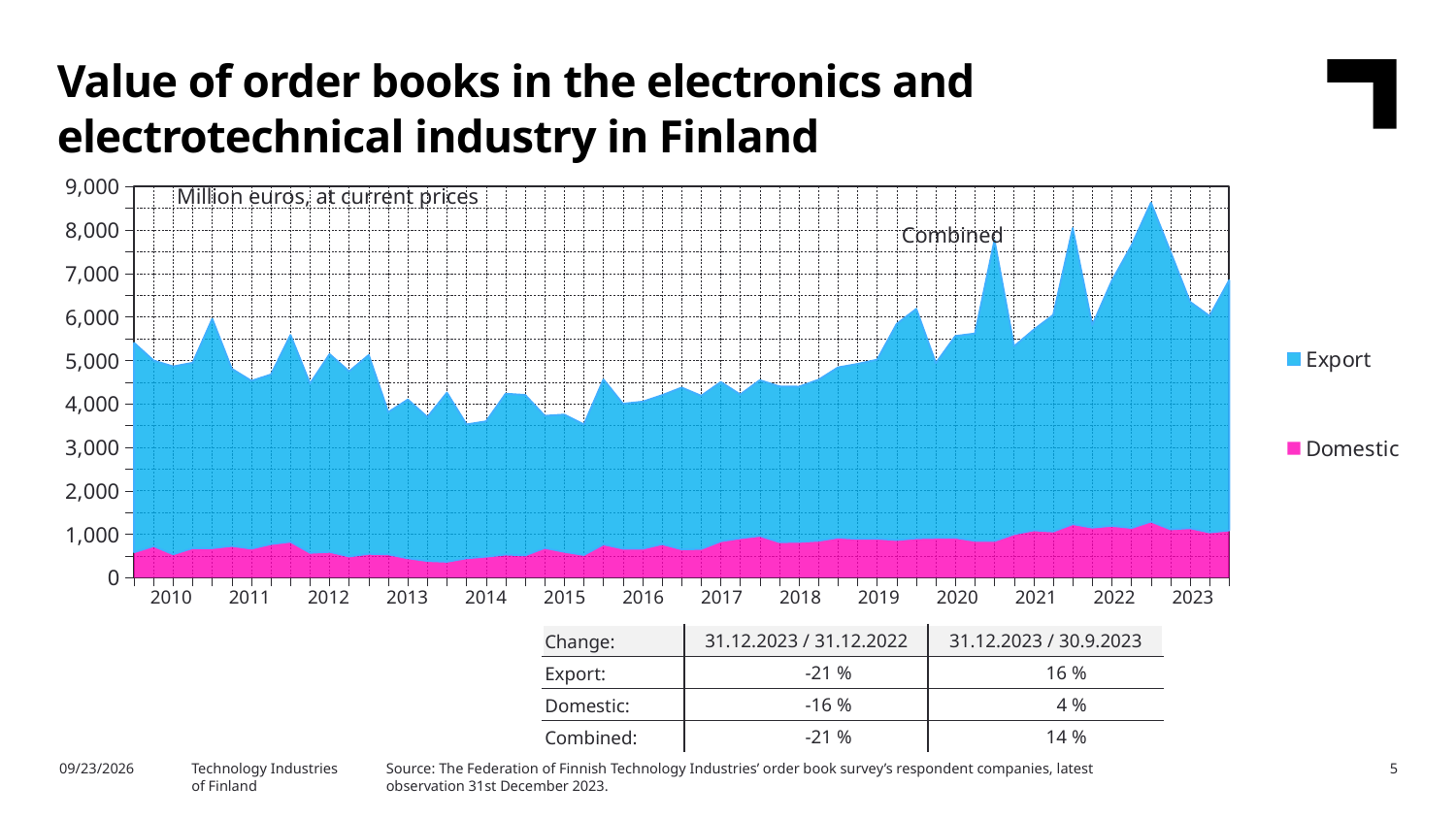
Is the highest combined peak in 2022 greater or less than 8,000? greater Is the lowest combined value around 2015 greater or less than 4,000? less Which series is larger throughout the period, Export or Domestic? Export In which year does the combined order book value reach its highest peak? 2022 What are the two series named in the legend? Export and Domestic Is the Domestic value at the end of 2023 greater or less than 2,000? less In what unit are the values on the chart expressed, according to the note inside the plot area? Million euros, at current prices How many series does the legend list? 2 How many years are labelled on the x axis? 14 What kind of chart is shown on the slide? Area chart Does the Domestic series generally rise or fall from 2010 to 2023? Rise